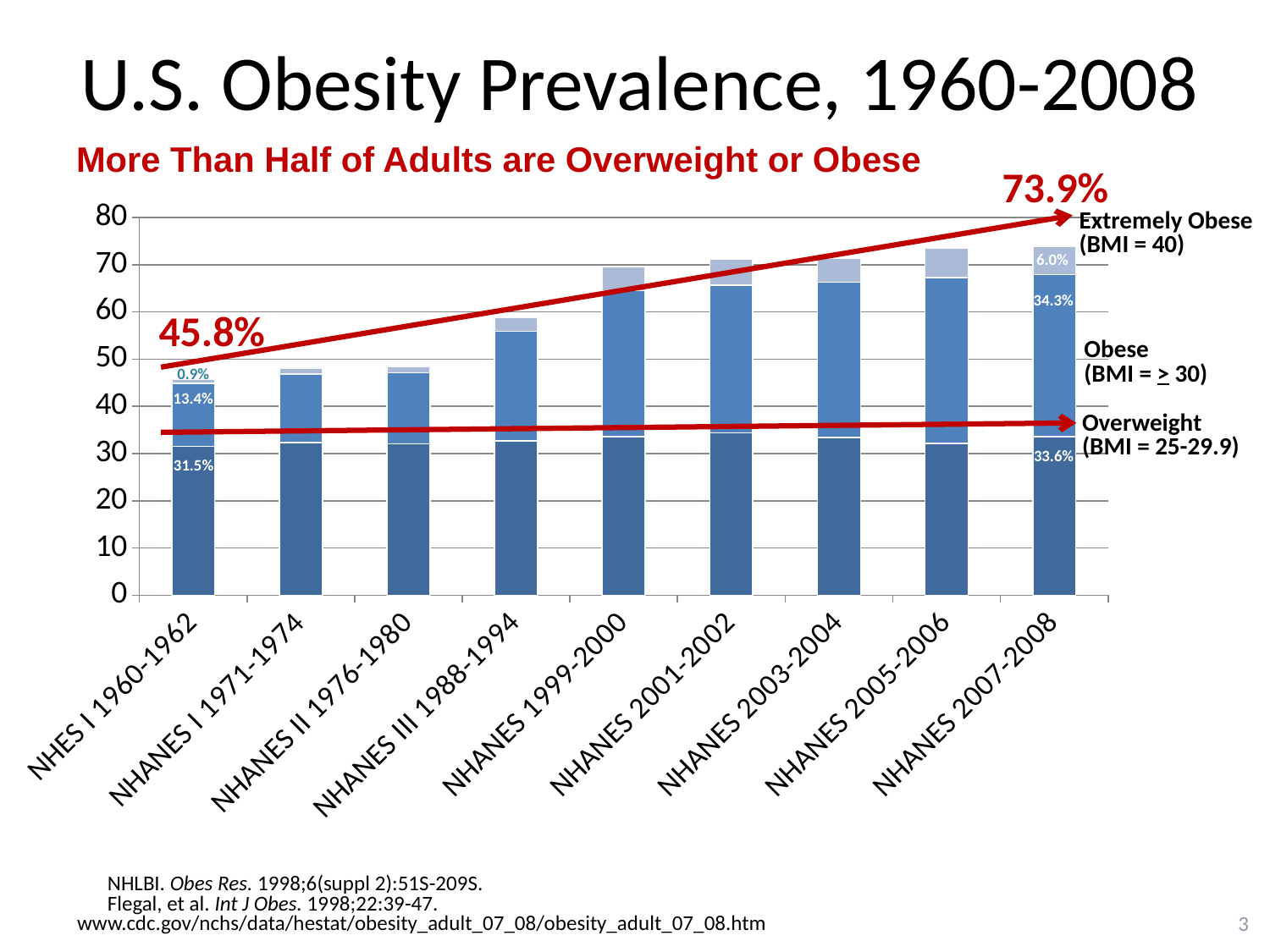
What is the obese (BMI = > 30) value for NHES I 1960-1962? 13.4% What is the total overweight-or-obese prevalence shown for NHES I 1960-1962? 45.8% What is the total overweight-or-obese prevalence shown for NHANES 2007-2008? 73.9% What is the overweight (BMI = 25-29.9) value for NHES I 1960-1962? 31.5% What is the obese (BMI = > 30) value for NHANES 2007-2008? 34.3% What is the overweight (BMI = 25-29.9) value for NHANES 2007-2008? 33.6% Does the total bar height generally rise or fall from NHES I 1960-1962 to NHANES 2007-2008? Rise What kind of chart is shown on the slide? Stacked bar chart What is the extremely obese (BMI = 40) value for NHANES 2007-2008? 6.0% What is the extremely obese (BMI = 40) value for NHES I 1960-1962? 0.9% How many survey periods are shown on the x axis? 9 What is the difference between the obese values for NHANES 2007-2008 and NHES I 1960-1962? 20.9%